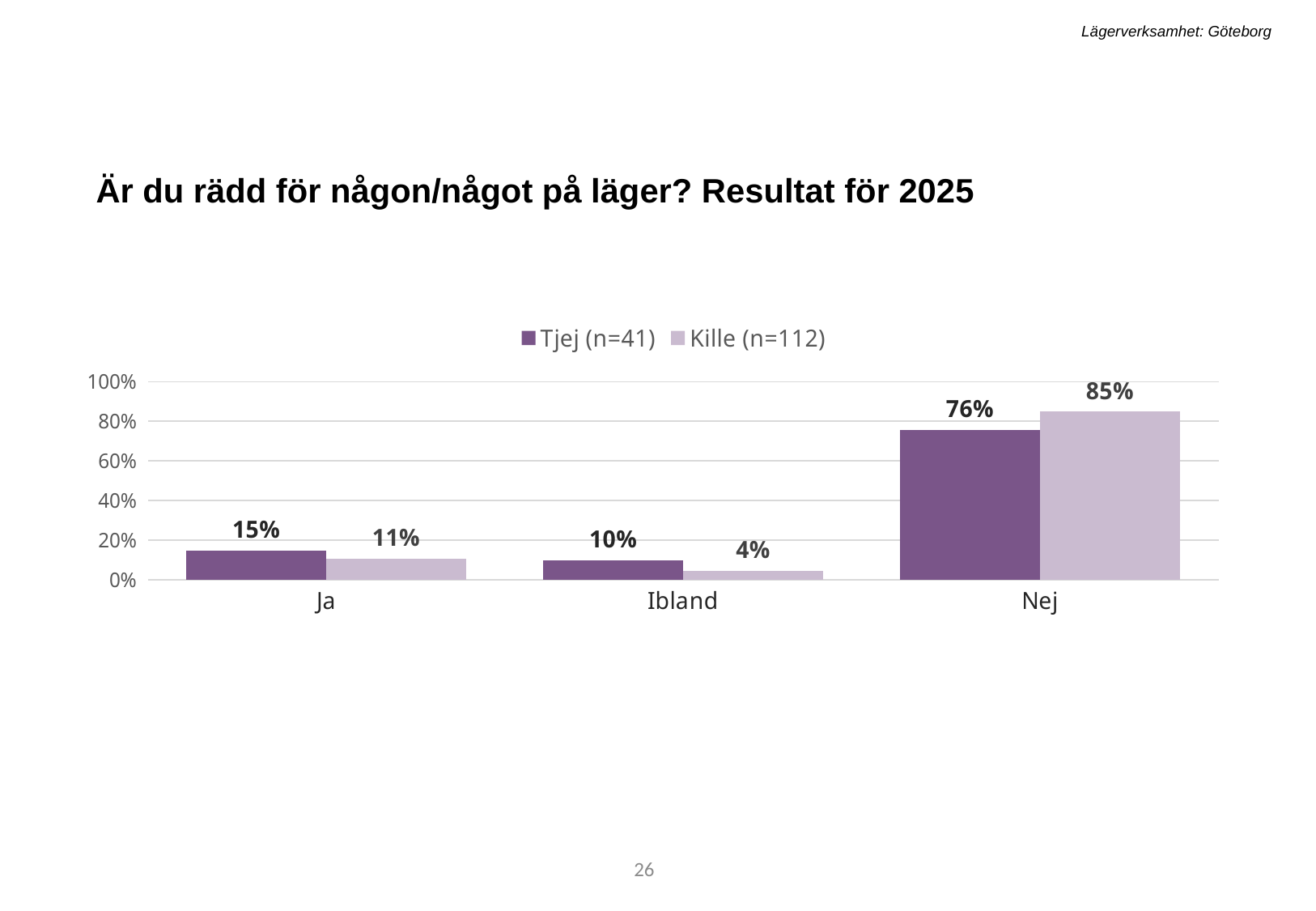
For the "Ja" category, which series has the larger value, Tjej (n=41) or Kille (n=112)? Tjej (n=41) What percentage of Tjej (n=41) answered "Ja"? 15% What percentage of Kille (n=112) answered "Nej"? 85% Which category has the lowest value for Kille (n=112)? Ibland What is the title of the chart on the slide? Är du rädd för någon/något på läger? Resultat för 2025 What is the difference between the Kille (n=112) and Tjej (n=41) values for "Nej"? 9 percentage points Which category has the highest value for Tjej (n=41)? Nej What is the value for Kille (n=112) in the "Ibland" category? 4% Is the value for Tjej (n=41) in the "Nej" category greater or less than 60%? greater What kind of chart is shown on the slide? Bar chart How many categories are shown on the x axis? 3 How many series does the legend list? 2